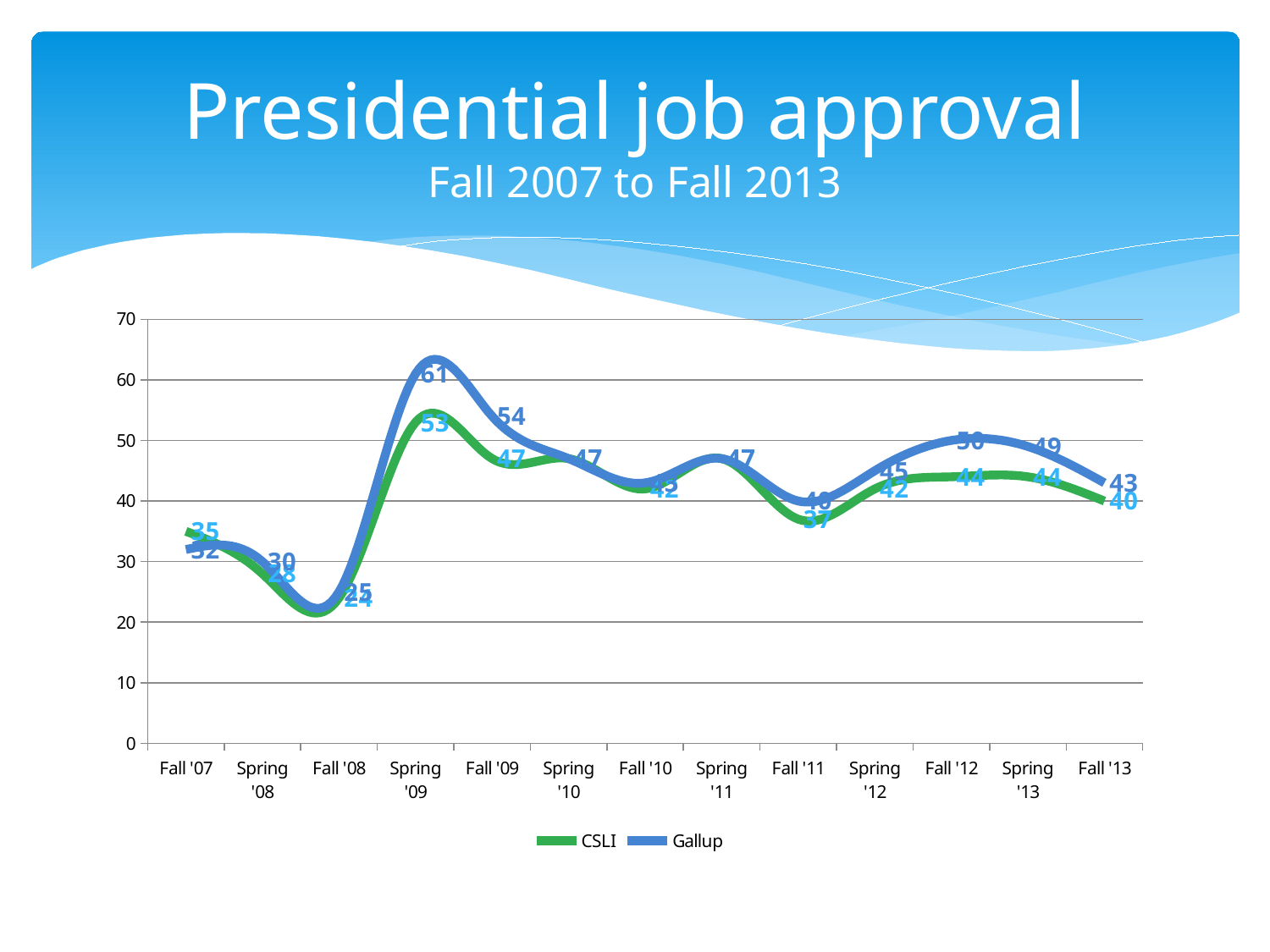
What is the Gallup value for Fall '12? 50 How many time points are plotted along the x axis? 13 What is the Gallup value for Spring '09? 61 What is the CSLI value for Fall '11? 37 What kind of chart is shown on the slide? Line chart At which time point does the Gallup series reach its highest value? Spring '09 What is the CSLI value for Spring '09? 53 In Fall '13, which series has the higher value, CSLI or Gallup? Gallup At which time point does the CSLI series reach its lowest value? Fall '08 How many series does the legend list? 2 Is the Gallup value for Spring '09 greater or less than 60? greater What is the difference between the Gallup and CSLI values in Spring '09? 8